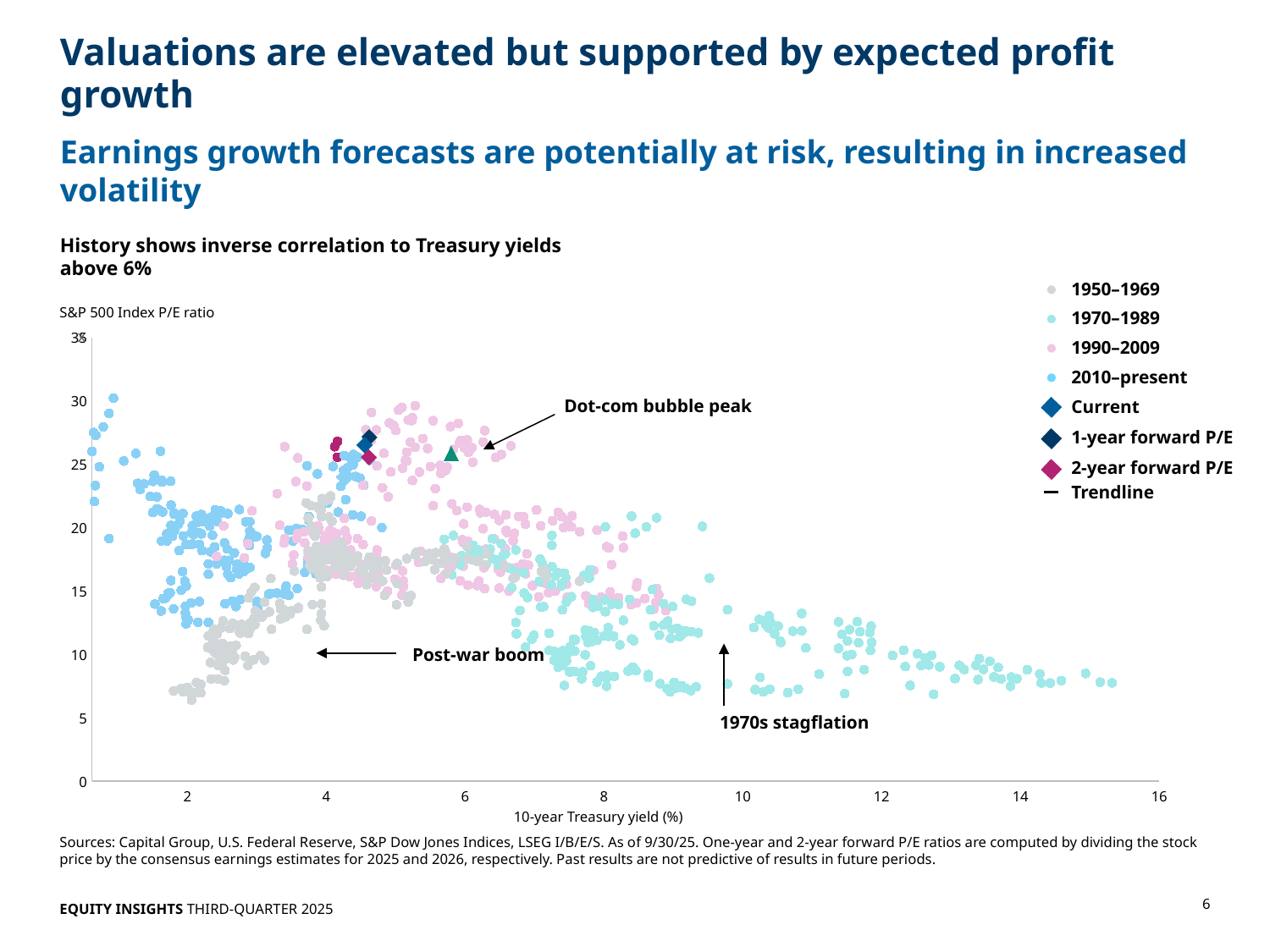
Is the P/E ratio of the 'Current' marker greater or less than 25? greater What is the title of the chart? History shows inverse correlation to Treasury yields above 6% Is the 10-year Treasury yield of the 'Current' marker greater or less than 6? less Are the P/E ratios of the points labelled '1970s stagflation' greater or less than 15? less What kind of chart is shown on the slide? Scatter chart As the 10-year Treasury yield rises above 6% along the x axis, does the S&P 500 P/E ratio generally rise or fall? fall How many entries does the chart's legend list? 8 Which period in the legend contains the points with the highest 10-year Treasury yields (above 12%)? 1970–1989 What is the label of the x axis of the chart? 10-year Treasury yield (%) What is the highest value shown on the x axis of the chart? 16